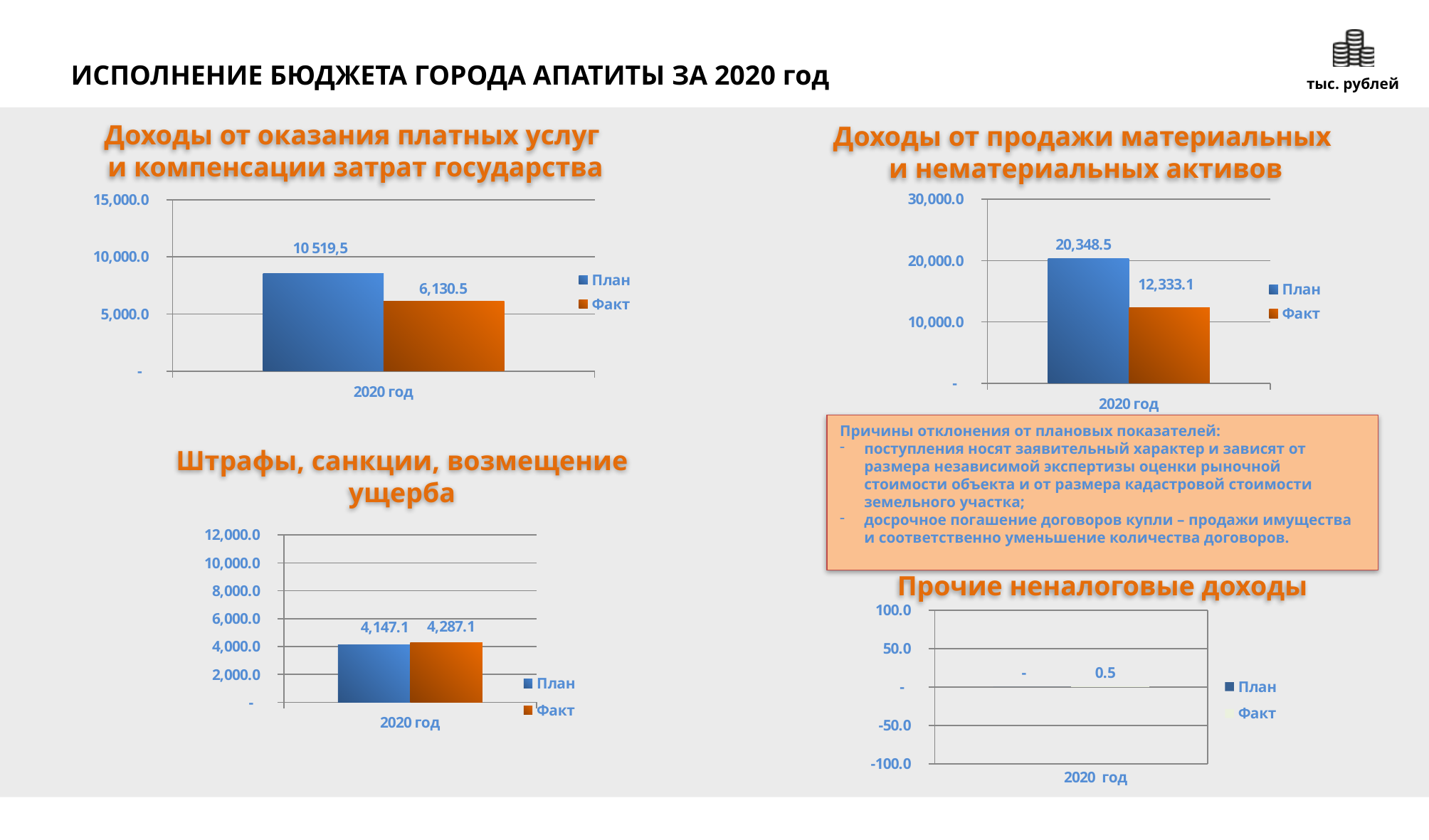
In the chart 'Доходы от оказания платных услуг и компенсации затрат государства', what is the value for План? 10 519,5 In the chart 'Доходы от продажи материальных и нематериальных активов', what is the value for План? 20,348.5 What type of chart is 'Штрафы, санкции, возмещение ущерба'? Bar chart In the chart 'Штрафы, санкции, возмещение ущерба', what is the difference between Факт and План? 140.0 How many series does the legend list in the chart 'Доходы от продажи материальных и нематериальных активов'? 2 In the chart 'Штрафы, санкции, возмещение ущерба', what is the value for Факт? 4,287.1 In the chart 'Прочие неналоговые доходы', what is the value for Факт? 0.5 In the chart 'Доходы от оказания платных услуг и компенсации затрат государства', which series is higher, План or Факт? План In the chart 'Доходы от продажи материальных и нематериальных активов', what is the difference between План and Факт? 8,015.4 In the chart 'Доходы от продажи материальных и нематериальных активов', what is the value for Факт? 12,333.1 In the chart 'Штрафы, санкции, возмещение ущерба', which is larger, План or Факт? Факт In the chart 'Доходы от оказания платных услуг и компенсации затрат государства', what is the value for Факт? 6,130.5